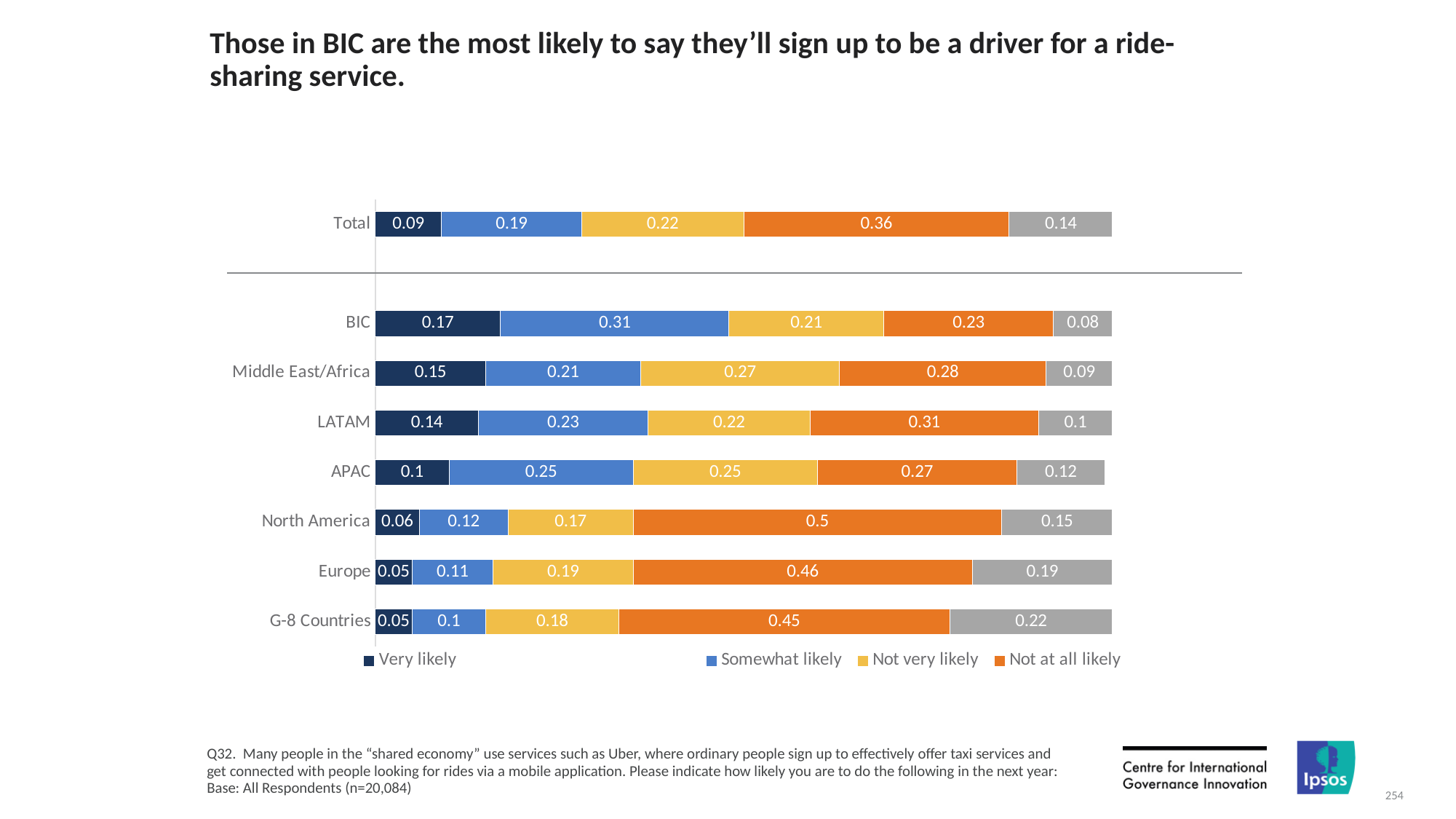
What is the 'Very likely' value for BIC? 0.17 What is the 'Somewhat likely' value for Middle East/Africa? 0.21 How many series does the legend list? 4 What is the combined 'Very likely' and 'Somewhat likely' value for G-8 Countries? 0.15 Which region has the lowest 'Not at all likely' value? BIC Which is larger, the 'Somewhat likely' value for LATAM or for APAC? APAC What is the 'Not at all likely' value for North America? 0.5 What kind of chart is shown on the slide? Stacked bar chart What is the difference between the 'Not at all likely' values for Europe and LATAM? 0.15 How many regions (including Total) are shown in the chart? 8 Which region has the highest 'Very likely' value? BIC What is the 'Not very likely' value for APAC? 0.25